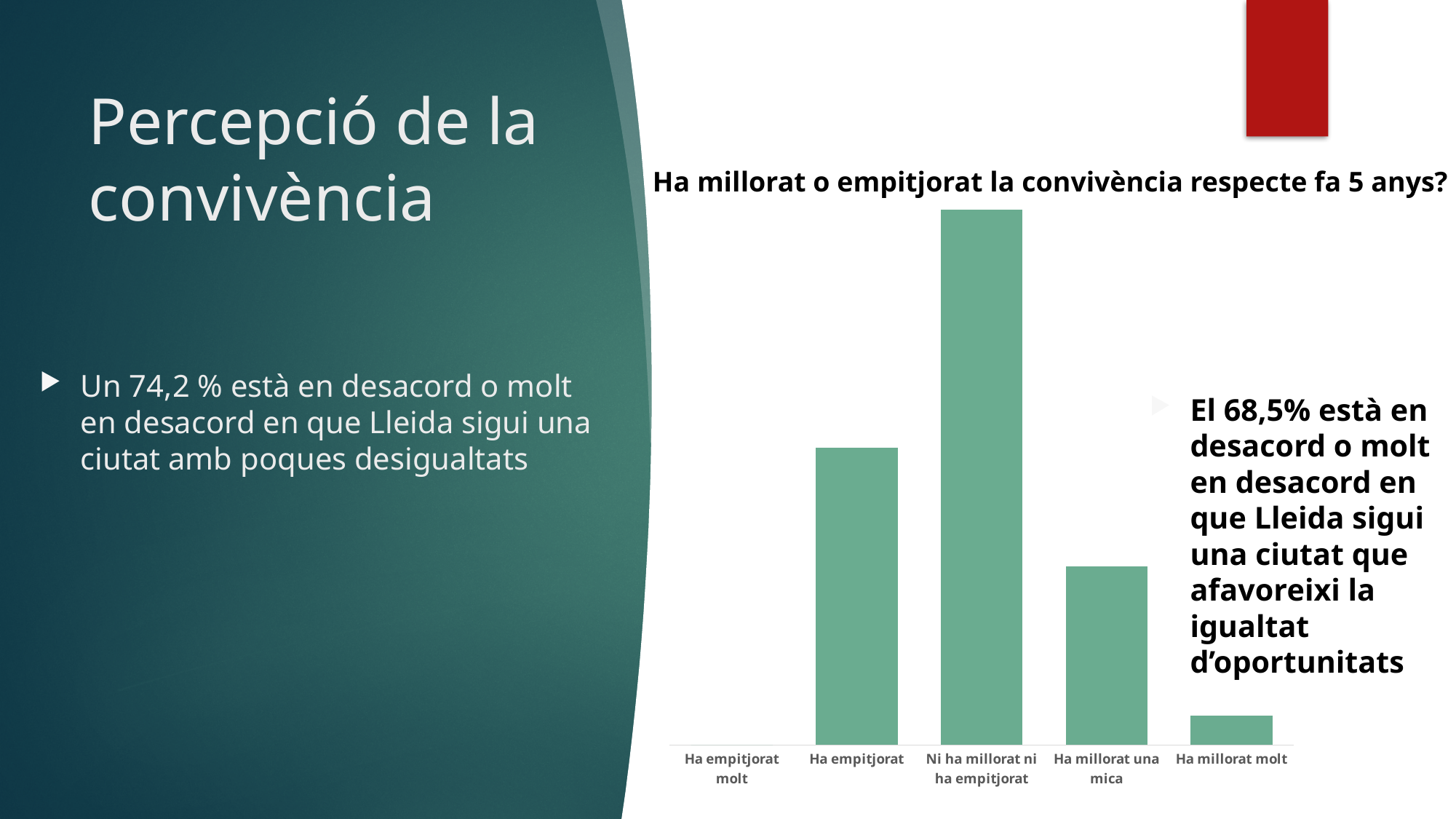
Which of the categories with a visible bar has the shortest bar? Ha millorat molt What kind of chart is shown on the slide? bar chart Which category has the highest bar in the chart? Ni ha millorat ni ha empitjorat Which is larger, the bar for 'Ni ha millorat ni ha empitjorat' or the bar for 'Ha empitjorat'? Ni ha millorat ni ha empitjorat How many categories are shown on the x axis of the chart? 5 Which category has no visible bar in the chart? Ha empitjorat molt What is the title of the chart? Ha millorat o empitjorat la convivència respecte fa 5 anys? Which is larger, the bar for 'Ha empitjorat' or the bar for 'Ha millorat una mica'? Ha empitjorat Which is larger, the bar for 'Ha millorat una mica' or the bar for 'Ha millorat molt'? Ha millorat una mica